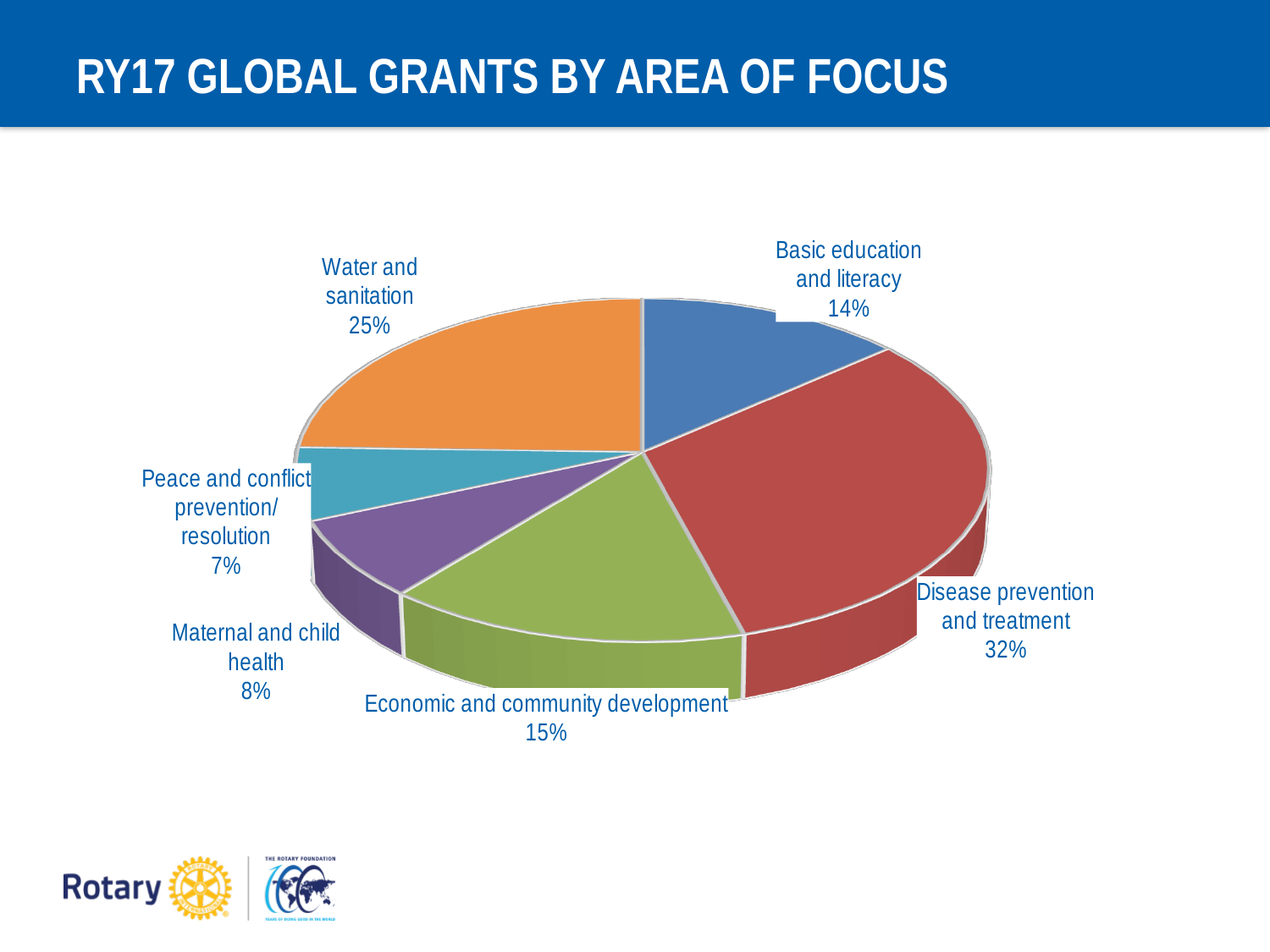
What kind of chart is shown on the slide? Pie chart What share of RY17 global grants went to Disease prevention and treatment? 32% What is the difference in percentage points between Disease prevention and treatment and Water and sanitation? 7 What share of RY17 global grants went to Water and sanitation? 25% How many areas of focus are shown in the pie chart? 6 What colour is the slice for Water and sanitation? Orange What is the title of the slide? RY17 GLOBAL GRANTS BY AREA OF FOCUS What percentage is shown for Basic education and literacy? 14% Which has a larger share: Economic and community development or Basic education and literacy? Economic and community development Which area of focus has the largest share of RY17 global grants? Disease prevention and treatment What percentage is shown for Maternal and child health? 8% Which area of focus has the smallest share of RY17 global grants? Peace and conflict prevention/resolution